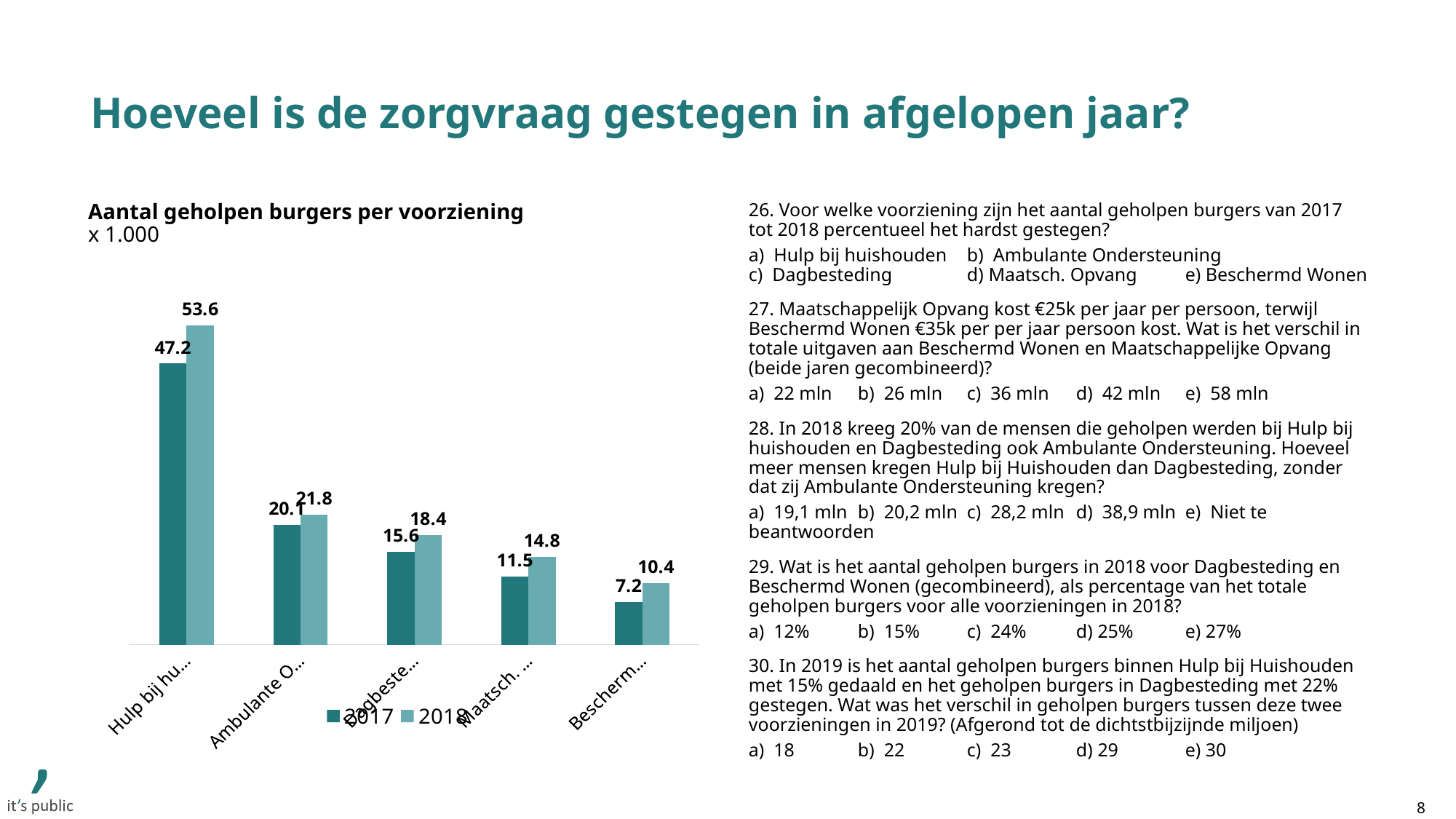
What is the 2018 value for Hulp bij huishouden in the chart 'Aantal geholpen burgers per voorziening'? 53.6 What is the 2017 value for Dagbesteding in the chart? 15.6 Which category has the highest 2018 value in the chart? Hulp bij huishouden What kind of chart is shown on the slide? Bar chart What is the difference between the 2018 and 2017 values for Maatsch. Opvang? 3.3 Which category has the lowest 2017 value in the chart? Beschermd Wonen Which is larger: the 2018 value for Dagbesteding or the 2018 value for Ambulante Ondersteuning? Ambulante Ondersteuning What is the difference between the 2018 and 2017 values for Hulp bij huishouden? 6.4 What is the 2017 value for Beschermd Wonen in the chart? 7.2 How many series does the chart legend list? 2 What unit note is shown under the chart title 'Aantal geholpen burgers per voorziening'? x 1.000 How many categories are shown on the x axis of the chart? 5